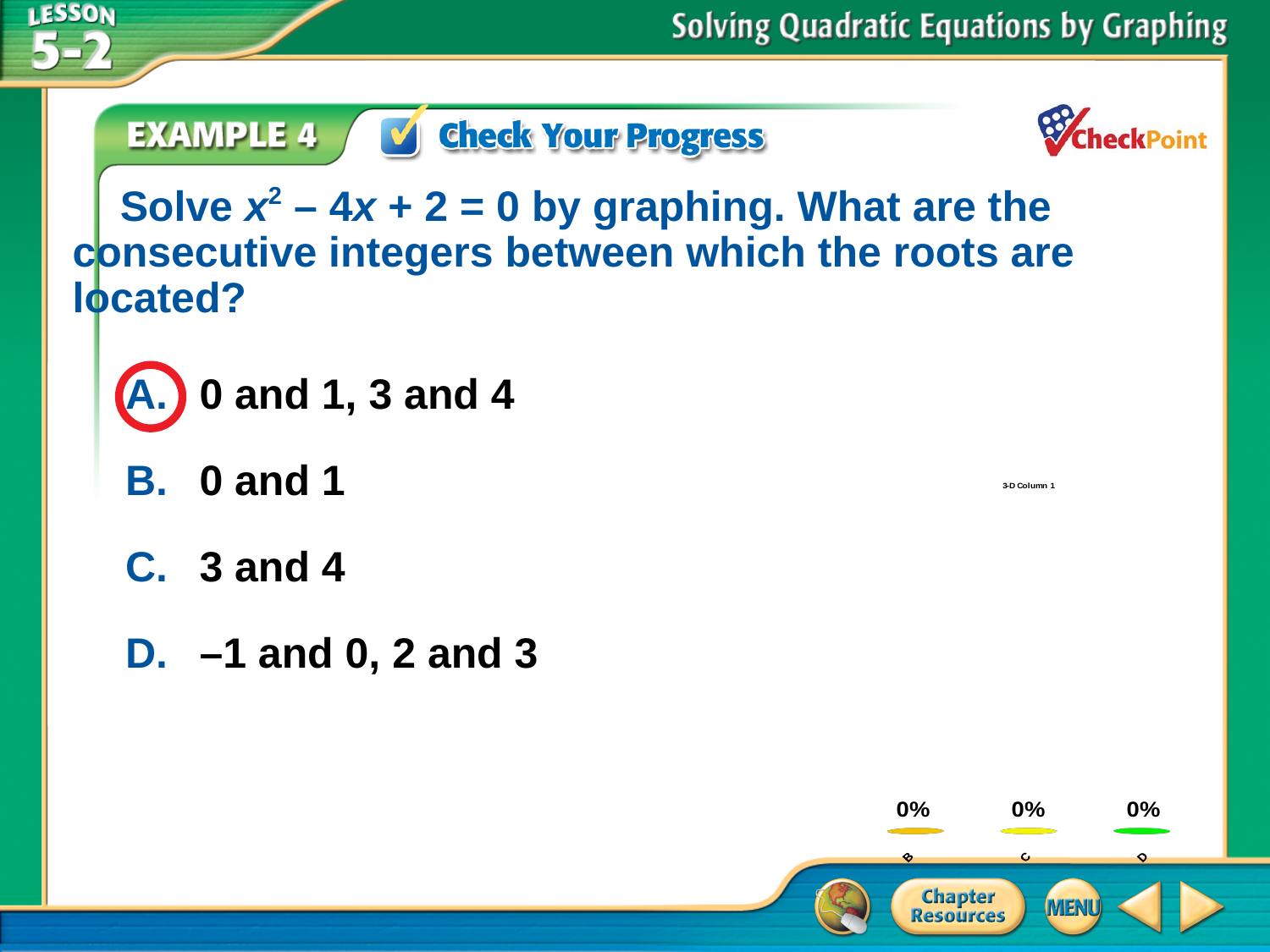
What is the value shown for category C in the chart at the bottom right of the slide? 0% In the chart at the bottom right, what is the difference between the values for C and D? 0% What is the value shown for category B in the chart at the bottom right of the slide? 0% What is the value shown for category D in the chart at the bottom right of the slide? 0% In the chart at the bottom right, is the value for B greater than or equal to the value for D? equal What kind of chart is shown at the bottom right of the slide? bar chart